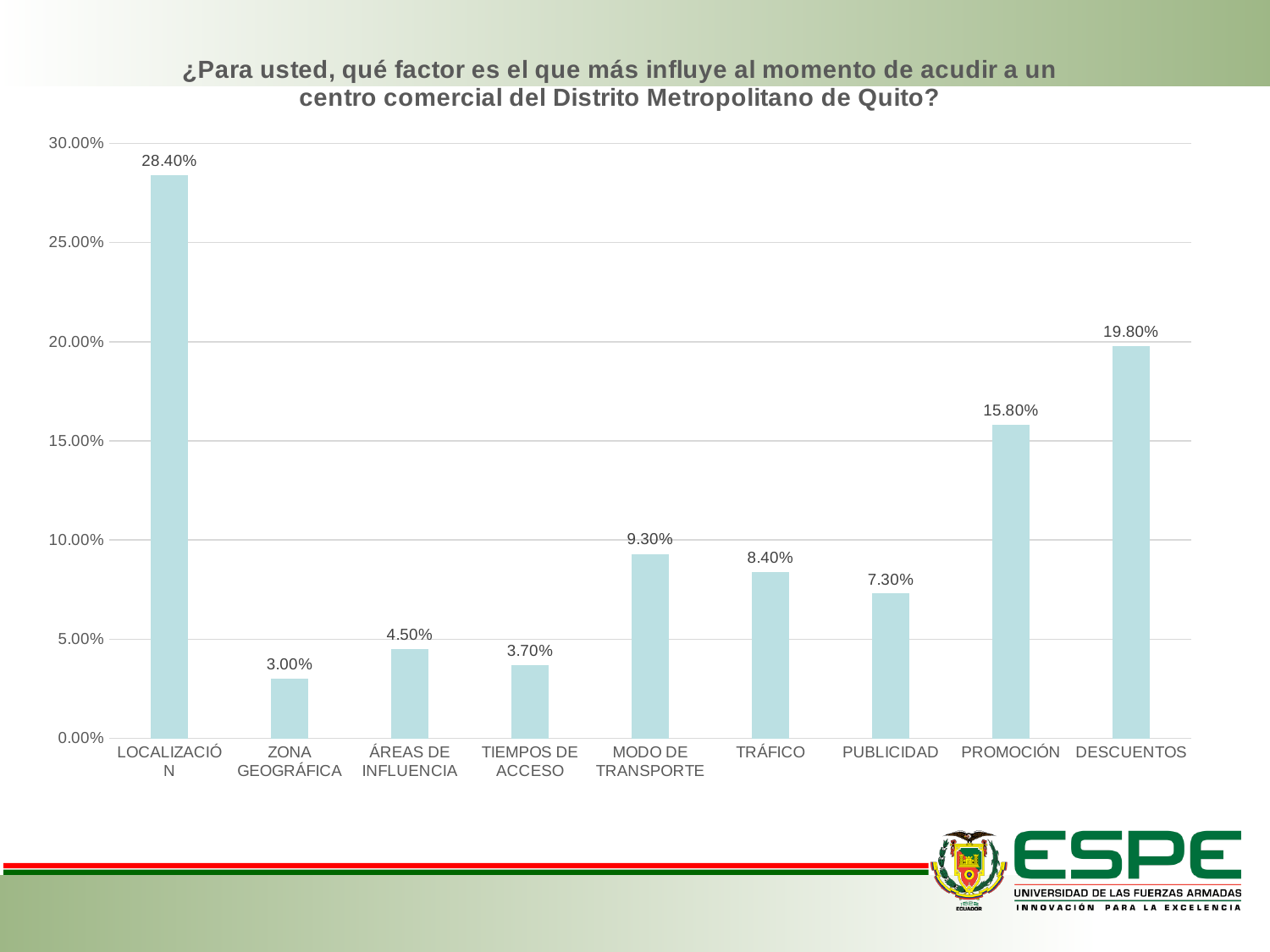
What is the value for DESCUENTOS? 19.80% What is the value for MODO DE TRANSPORTE? 9.30% What is the difference between the values for ÁREAS DE INFLUENCIA and TIEMPOS DE ACCESO? 0.80% Is the value for PROMOCIÓN greater or less than 15.00%? greater Which is larger, the value for TRÁFICO or the value for PUBLICIDAD? TRÁFICO What is the value for LOCALIZACIÓN? 28.40% Which category has the highest value? LOCALIZACIÓN What is the difference between the values for LOCALIZACIÓN and DESCUENTOS? 8.60% How many categories are shown on the x axis? 9 Which category has the lowest value? ZONA GEOGRÁFICA What kind of chart is shown on the slide? bar chart What is the value for PUBLICIDAD? 7.30%